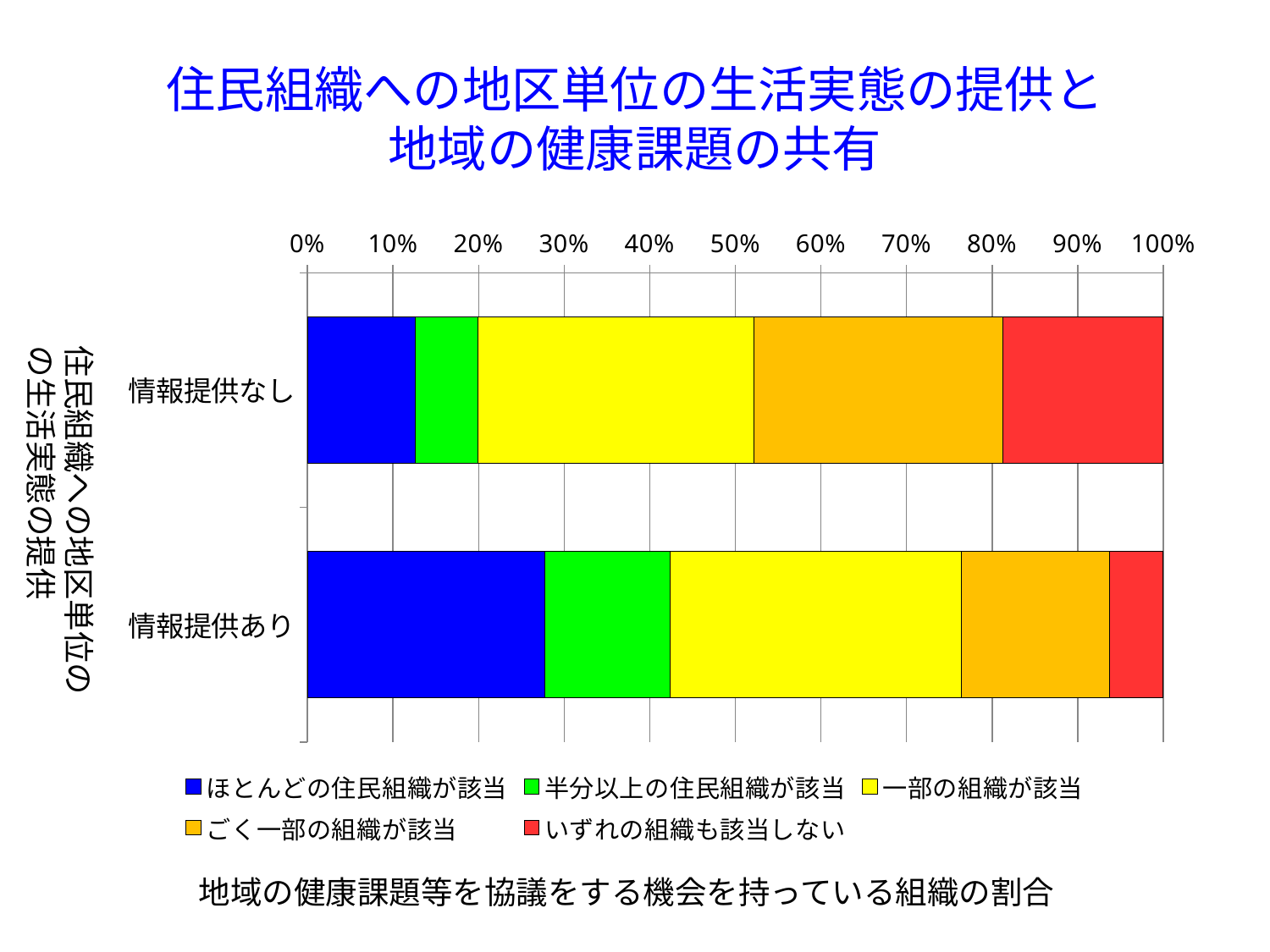
What colour represents いずれの組織も該当しない in the chart? Red Is the value of ほとんどの住民組織が該当 for 情報提供なし greater or less than 20%? less What kind of chart is shown on the slide? Stacked bar chart Is the value of いずれの組織も該当しない for 情報提供なし greater or less than 10%? greater How many categories (bars) does the chart show? 2 Which category has the larger share of いずれの組織も該当しない, 情報提供あり or 情報提供なし? 情報提供なし Which category has the larger share of ほとんどの住民組織が該当, 情報提供あり or 情報提供なし? 情報提供あり Is the value of いずれの組織も該当しない for 情報提供あり greater or less than 10%? less How many series does the legend list? 5 Which category has the larger share of 半分以上の住民組織が該当, 情報提供あり or 情報提供なし? 情報提供あり